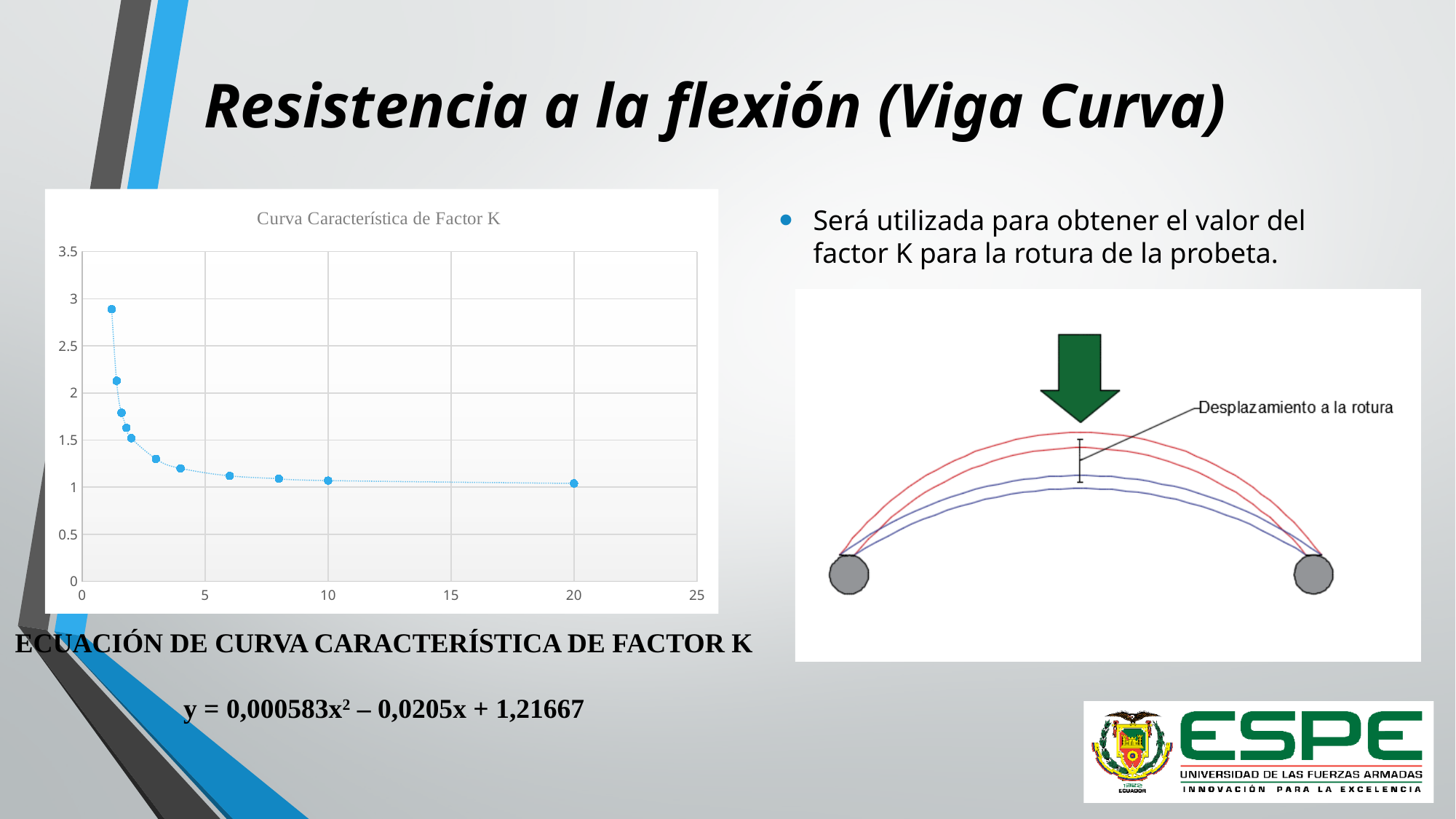
Which point has the highest value: the one at x = 1 or the one at x = 20? the one at x = 1 Do the plotted values rise or fall as x increases along the x axis? fall Is the value of the point at x = 10 greater or less than 2? less Is the value of the point at x = 4 greater or less than 1.5? less What kind of chart is shown on the slide? scatter chart What is the maximum value shown on the x axis of the chart? 25 How many data points are plotted on the chart? 11 What is the title of the chart on the slide? Curva Característica de Factor K Is the value of the point at x = 20 greater or less than 1.5? less